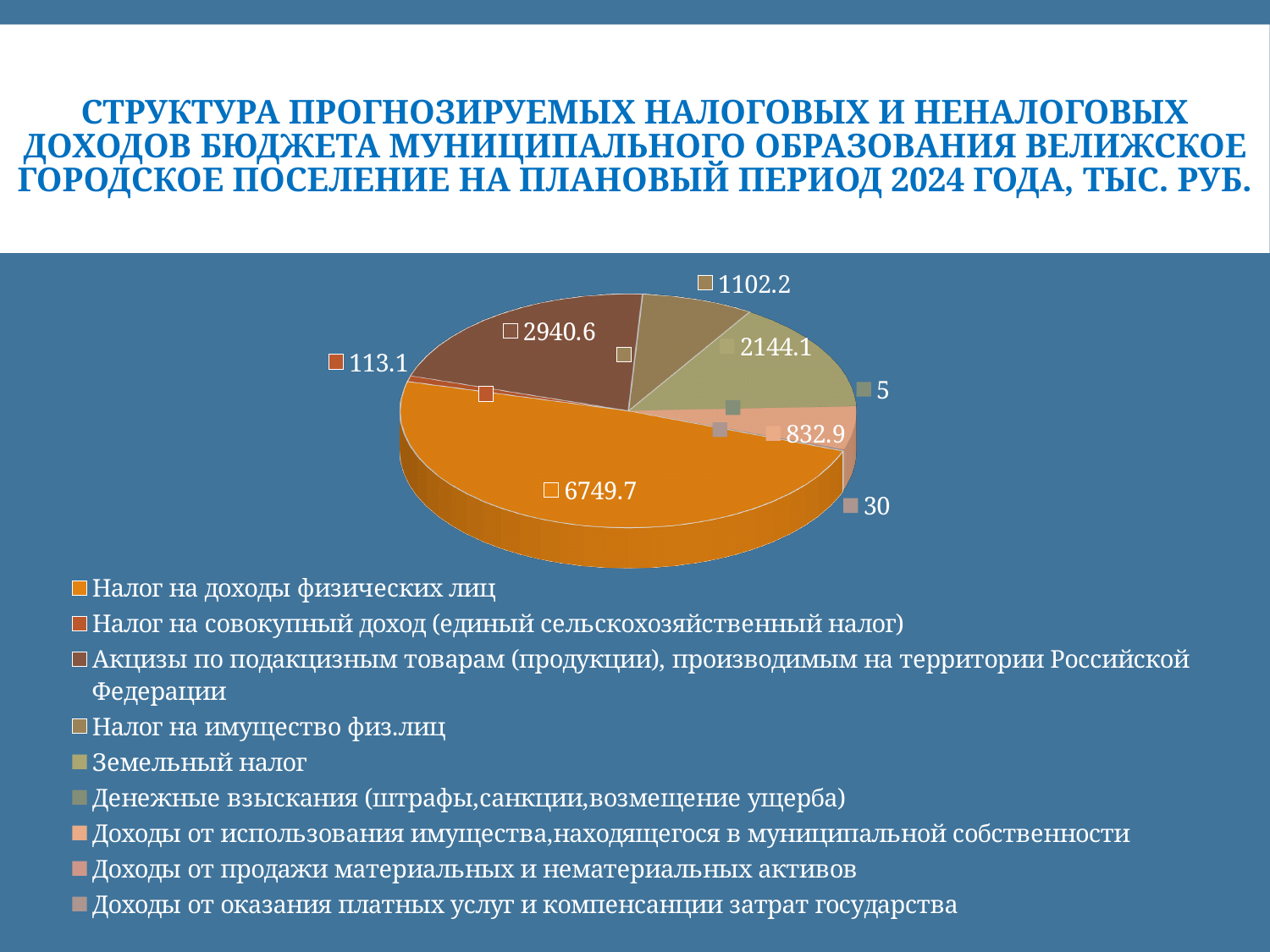
What is the value for Налог на совокупный доход (единый сельскохозяйственный налог)? 113.1 What is the smallest value printed on the chart? 5 What is the difference between the values for Акцизы по подакцизным товарам and Земельный налог? 796.5 Which year does the chart title refer to? 2024 Which is larger: Земельный налог or Налог на имущество физ.лиц? Земельный налог What is the value for Налог на имущество физ.лиц? 1102.2 What kind of chart is shown on the slide? pie chart Which category has the largest slice of the pie? Налог на доходы физических лиц What is the value for Акцизы по подакцизным товарам (продукции), производимым на территории Российской Федерации? 2940.6 What is the value for Земельный налог? 2144.1 What is the value for Налог на доходы физических лиц? 6749.7 How many categories does the legend list? 9